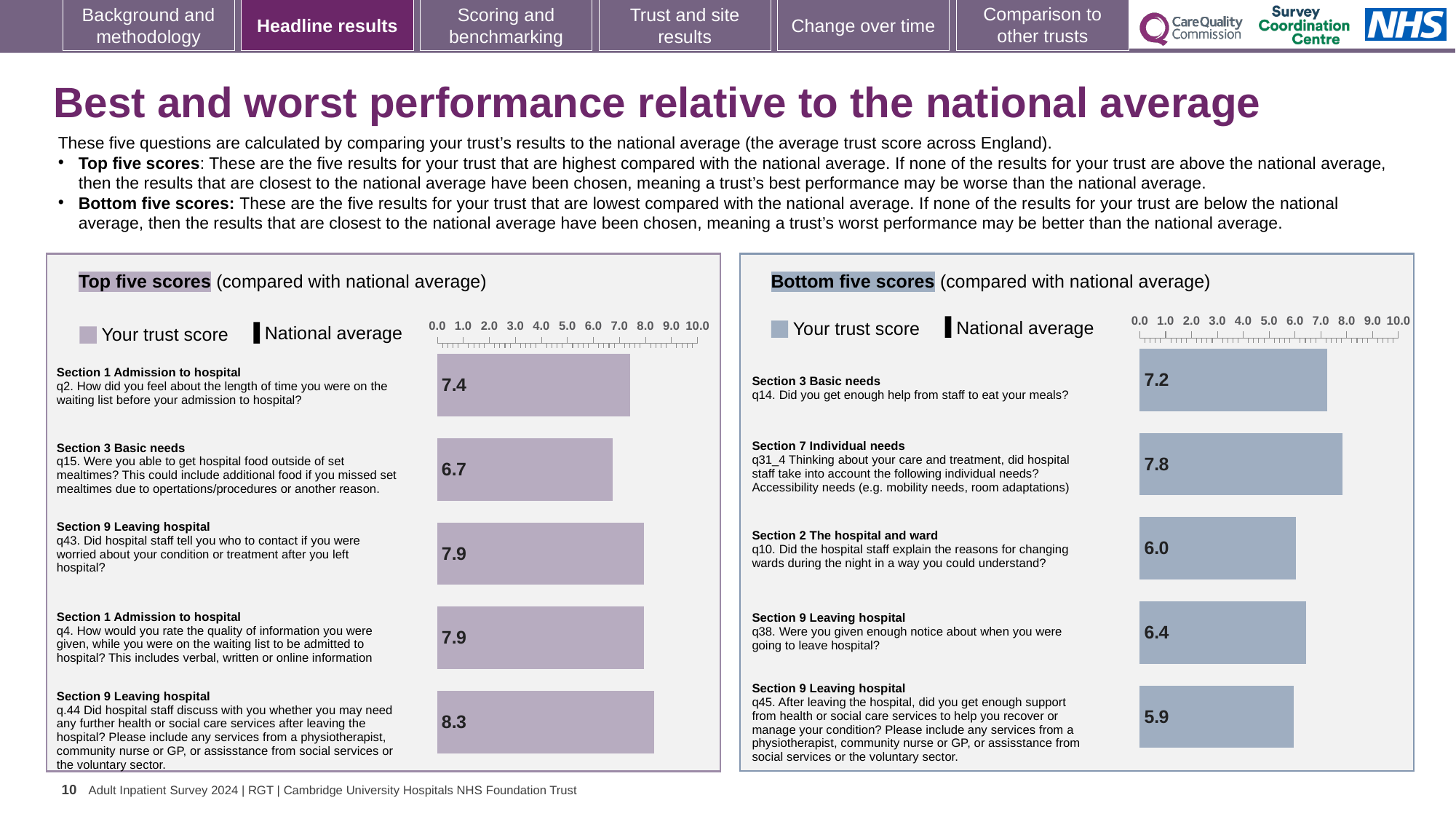
In the Bottom five scores chart, which question has the highest trust score? q31_4 (accessibility needs) In the Top five scores chart, which question has the lowest trust score? q15 (hospital food outside of set mealtimes) In the Bottom five scores chart, what is the trust score for q45 about support from health or social care services after leaving hospital? 5.9 What type of chart is used in the Top five scores panel? Bar chart In the Top five scores chart, which question has the highest trust score? q.44 (further health or social care services after leaving hospital) In the Bottom five scores chart, what is the trust score for q14 about getting enough help from staff to eat meals? 7.2 In the Top five scores chart, what is the trust score for q2 about the length of time on the waiting list before admission? 7.4 In the Top five scores chart, what is the trust score for q15 about getting hospital food outside of set mealtimes? 6.7 In the Top five scores chart, how many questions are plotted? 5 In the Bottom five scores chart, what is the difference between the trust scores for q31_4 and q45? 1.9 In the Top five scores chart, what is the difference between the trust scores for q.44 and q15? 1.6 In the Bottom five scores chart, which is larger, the trust score for q10 or for q38? q38